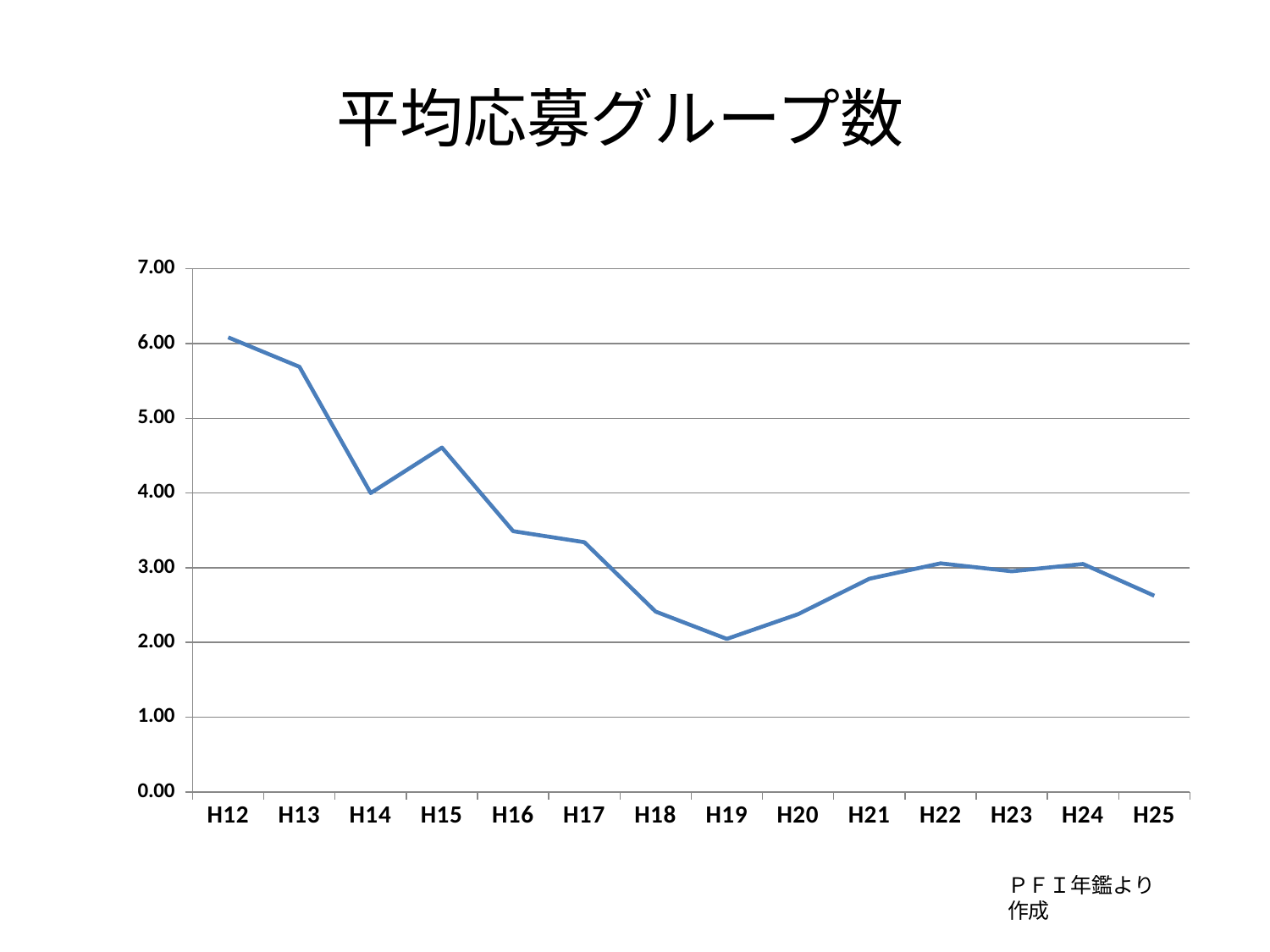
Which year has the highest average number of applicant groups? H12 Is the value for H18 greater or less than 3.00? less Is the value for H15 greater or less than 4.00? greater Is the value for H12 greater or less than 6.00? greater What kind of chart is shown on the slide? line chart Which is larger, the value for H13 or the value for H14? H13 What is the title of the chart? 平均応募グループ数 Which is larger, the value for H15 or the value for H16? H15 Which year has the lowest average number of applicant groups? H19 How many years (categories) are plotted along the x axis? 14 Overall, do the values rise or fall from H12 to H19? fall